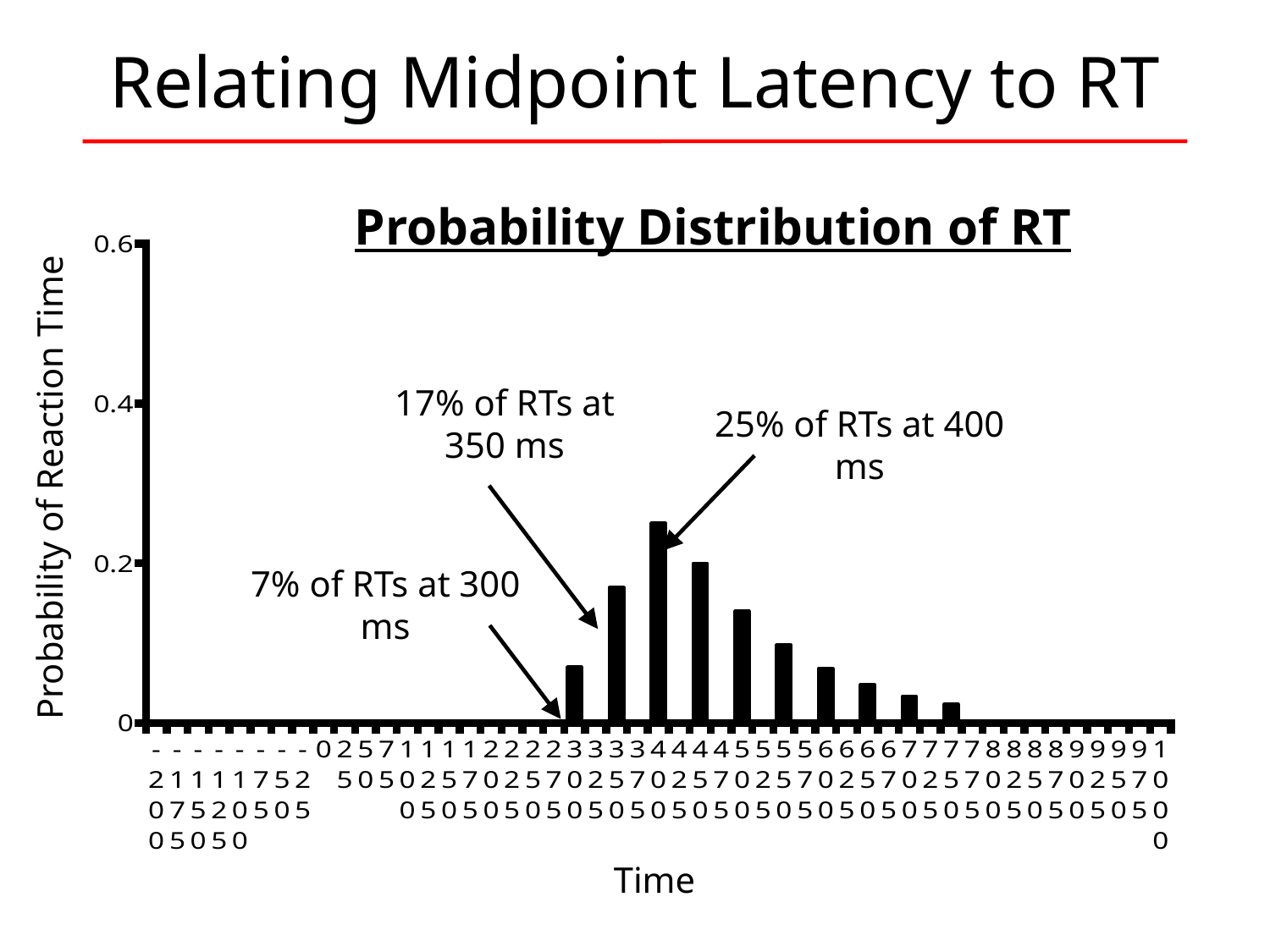
According to the annotation, what percentage of RTs occur at 350 ms? 17% Which has a higher probability, the bar at 300 ms or the bar at 400 ms? 400 ms According to the annotation, what percentage of RTs occur at 400 ms? 25% What type of chart is shown on the slide? bar chart Is the value of the bar at 350 ms greater or less than 0.2? less Do the bar values rise or fall moving to the right of the 400 ms bar? fall At which time does the tallest bar occur? 400 ms What is the difference between the percentage of RTs at 400 ms and at 300 ms? 18% What is the title of the chart? Probability Distribution of RT According to the annotation, what percentage of RTs occur at 300 ms? 7% What is the label of the y-axis? Probability of Reaction Time What is the difference between the percentage of RTs at 400 ms and at 350 ms? 8%